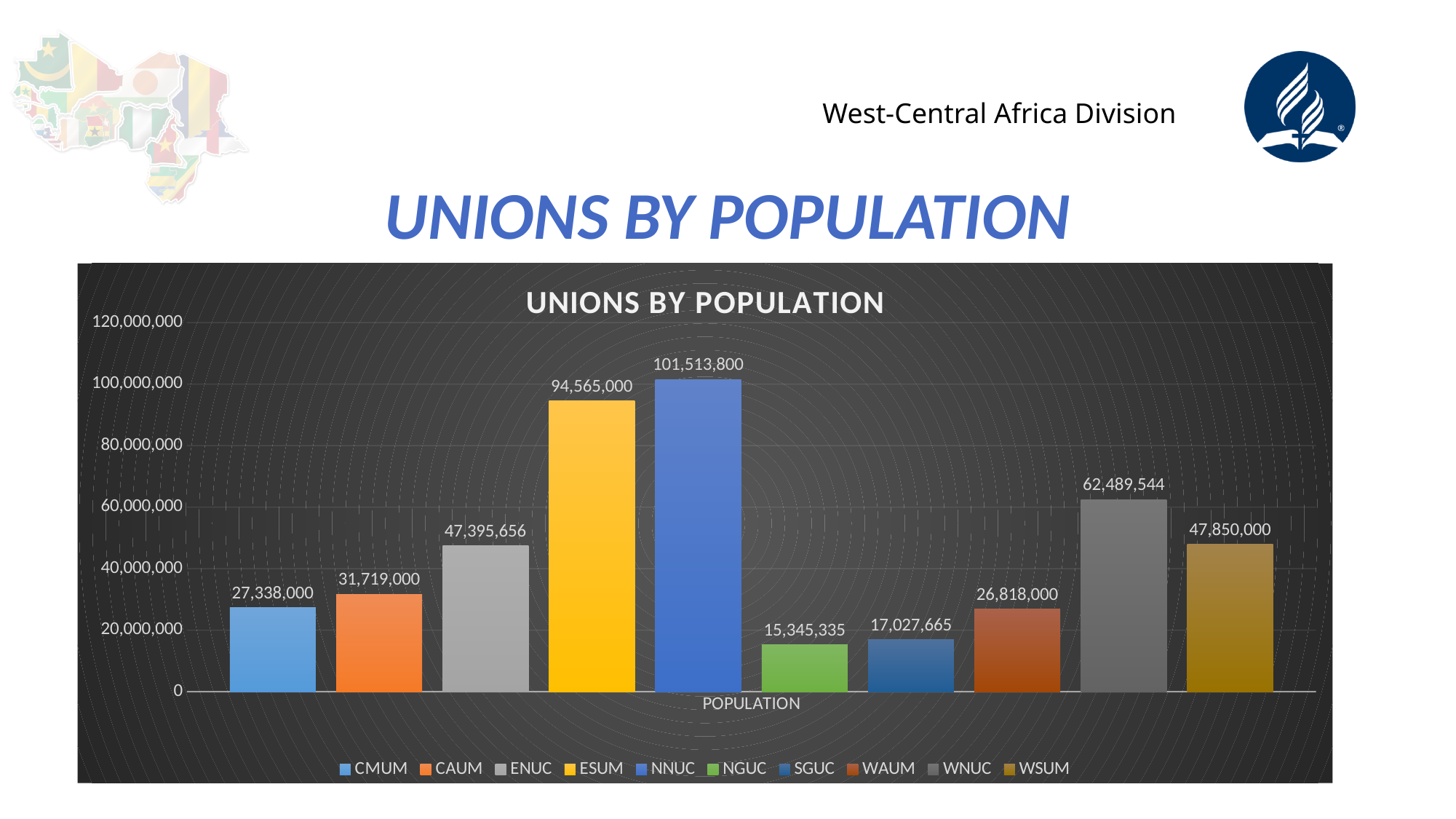
What is the population value for WNUC? 62,489,544 Which union has the highest population? NNUC What type of chart is shown on the slide? Bar chart What is the difference in population between CAUM and CMUM? 4,381,000 Which has a larger population, WNUC or ESUM? ESUM What is the difference in population between NNUC and ESUM? 6,948,800 What is the population value for NNUC? 101,513,800 Which union has the lowest population? NGUC What is the population value for NGUC? 15,345,335 How many unions are shown in the chart? 10 What is the title of the chart? UNIONS BY POPULATION Is the population value for WAUM greater or less than 40,000,000? less